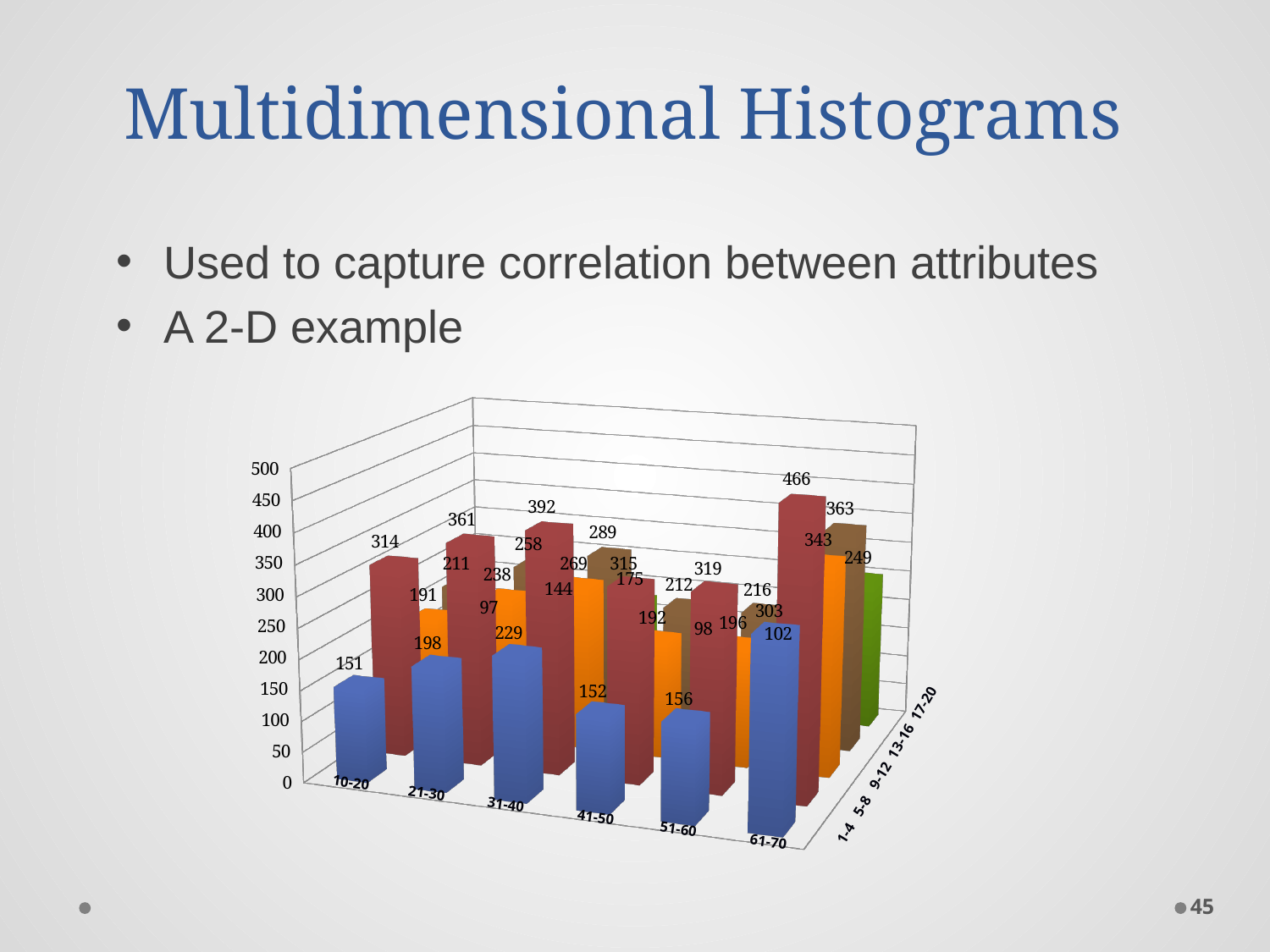
What is the value of the red (5-8) bar for the 61-70 category? 466 What is the value of the red (5-8) bar for the 31-40 category? 392 What is the value of the blue (1-4) bar for the 31-40 category? 229 What is the largest value printed on the chart? 466 Which is larger: the blue (1-4) bar for 21-30 or the blue (1-4) bar for 41-50? 21-30 What is the smallest value printed on the chart? 97 What is the value of the blue (1-4) bar for the 10-20 category? 151 What is the difference between the red (5-8) bar for 61-70 (466) and the red (5-8) bar for 31-40 (392)? 74 What is the value of the green (17-20) bar for the 61-70 category? 249 What kind of chart is shown on the slide? bar chart How many series (depth-axis groups) does the chart show? 5 How many categories are shown along the front (x) axis of the chart? 6